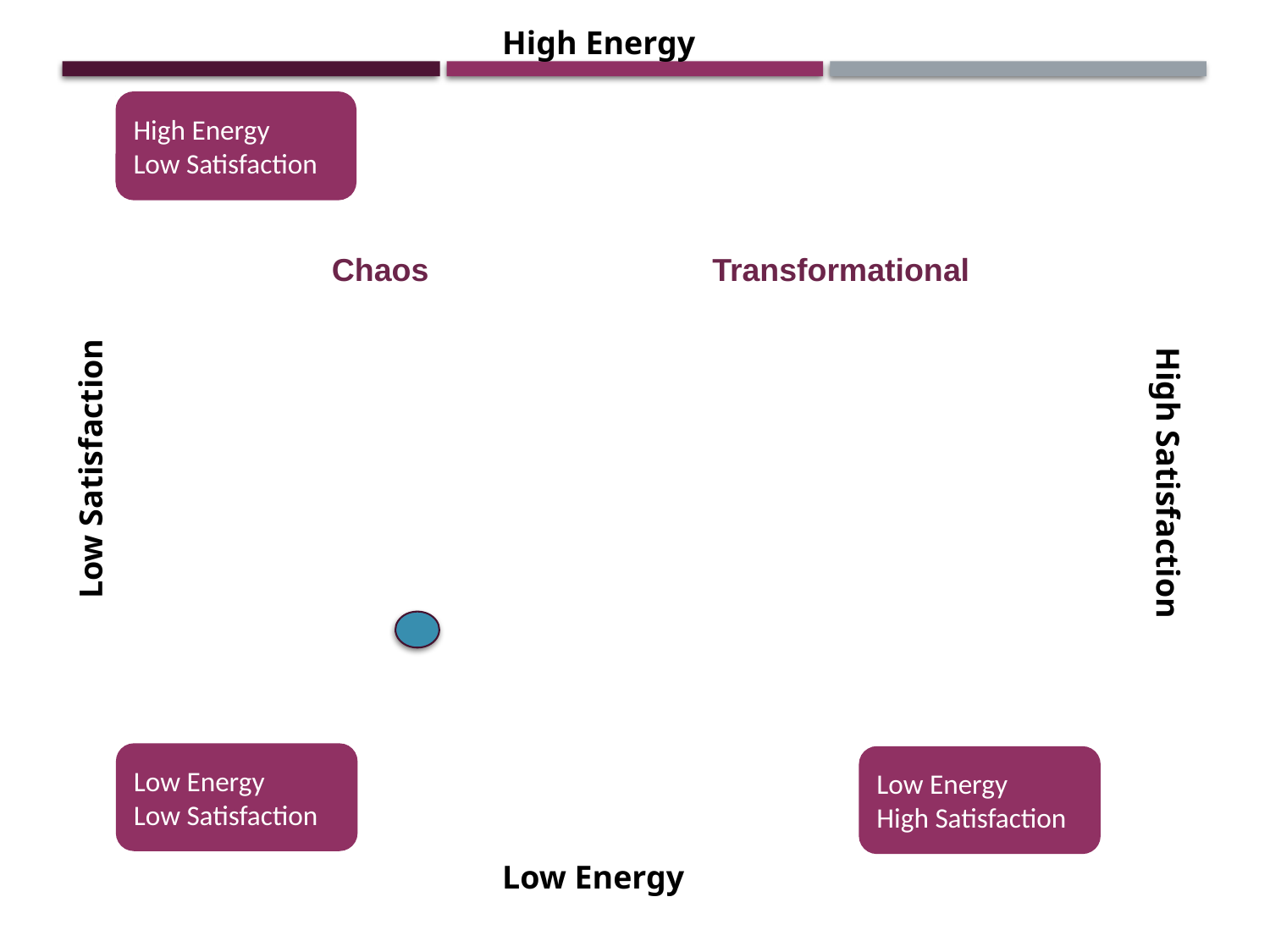
How many data points are plotted on the quadrant matrix? 1 What label is given to the upper-right quadrant of the matrix? Transformational What kind of chart is shown on the slide? A 2x2 quadrant matrix What label is given to the upper-left quadrant of the matrix? Chaos In which quadrant does the blue dot sit? Low Energy, Low Satisfaction Is the blue dot closer to the Low Energy side or the High Energy side of the matrix? Low Energy